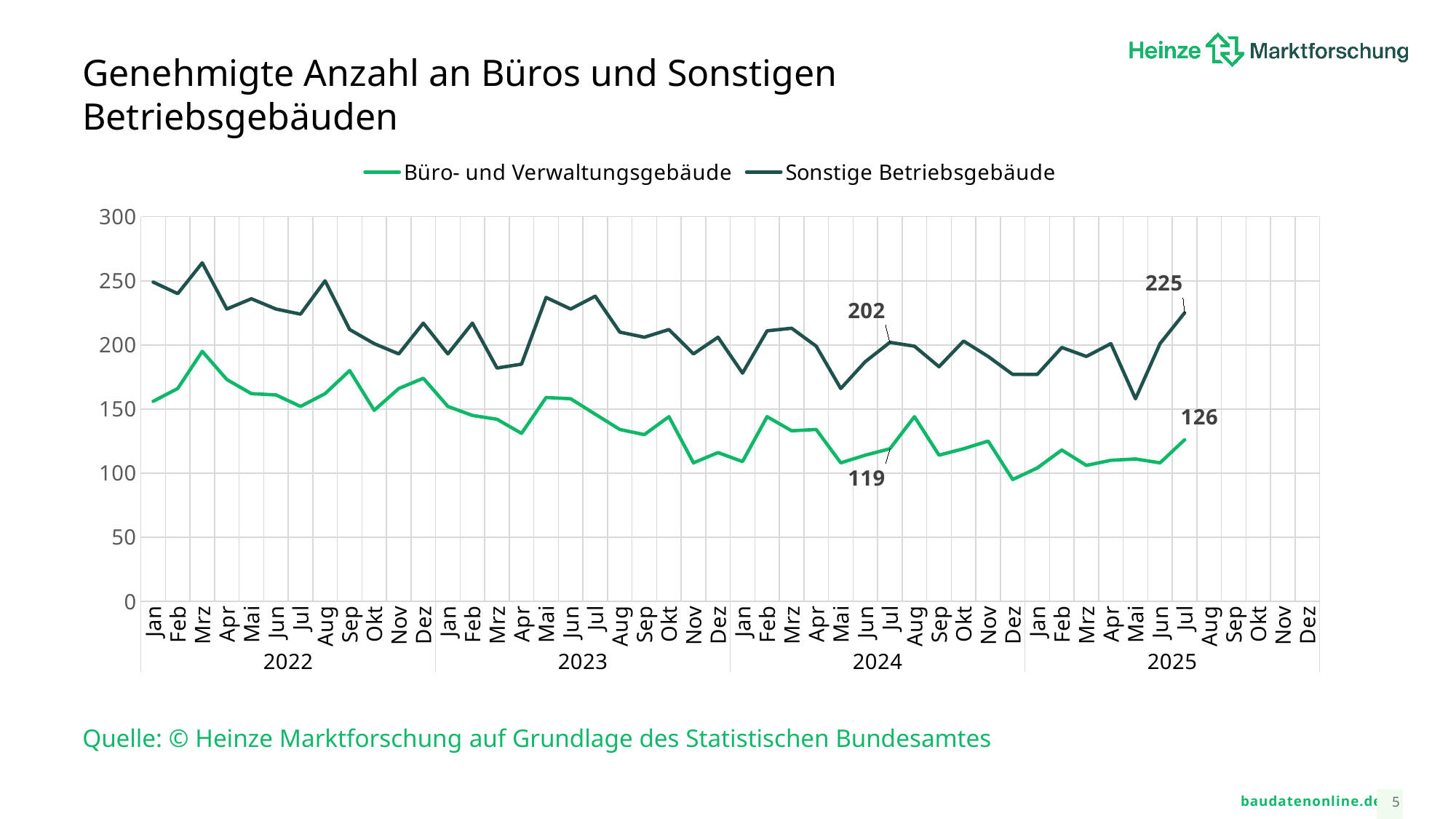
What is the labelled value for Büro- und Verwaltungsgebäude in Jul 2025? 126 Is the value for Büro- und Verwaltungsgebäude in Dez 2024 greater or less than 100? less Does the Sonstige Betriebsgebäude line rise or fall from Mai 2025 to Jul 2025? rise Which series has the higher value in Jul 2025, Büro- und Verwaltungsgebäude or Sonstige Betriebsgebäude? Sonstige Betriebsgebäude What is the labelled value for Büro- und Verwaltungsgebäude in Jul 2024? 119 Is the value for Sonstige Betriebsgebäude in Mrz 2022 greater or less than 250? greater How many series does the legend list? 2 By how much did the labelled value for Sonstige Betriebsgebäude change from Jul 2024 to Jul 2025? 23 What type of chart is shown on the slide? line chart What is the labelled value for Sonstige Betriebsgebäude in Jul 2024? 202 What is the difference between the Jul 2025 values of Sonstige Betriebsgebäude and Büro- und Verwaltungsgebäude? 99 What is the labelled value for Sonstige Betriebsgebäude in Jul 2025? 225